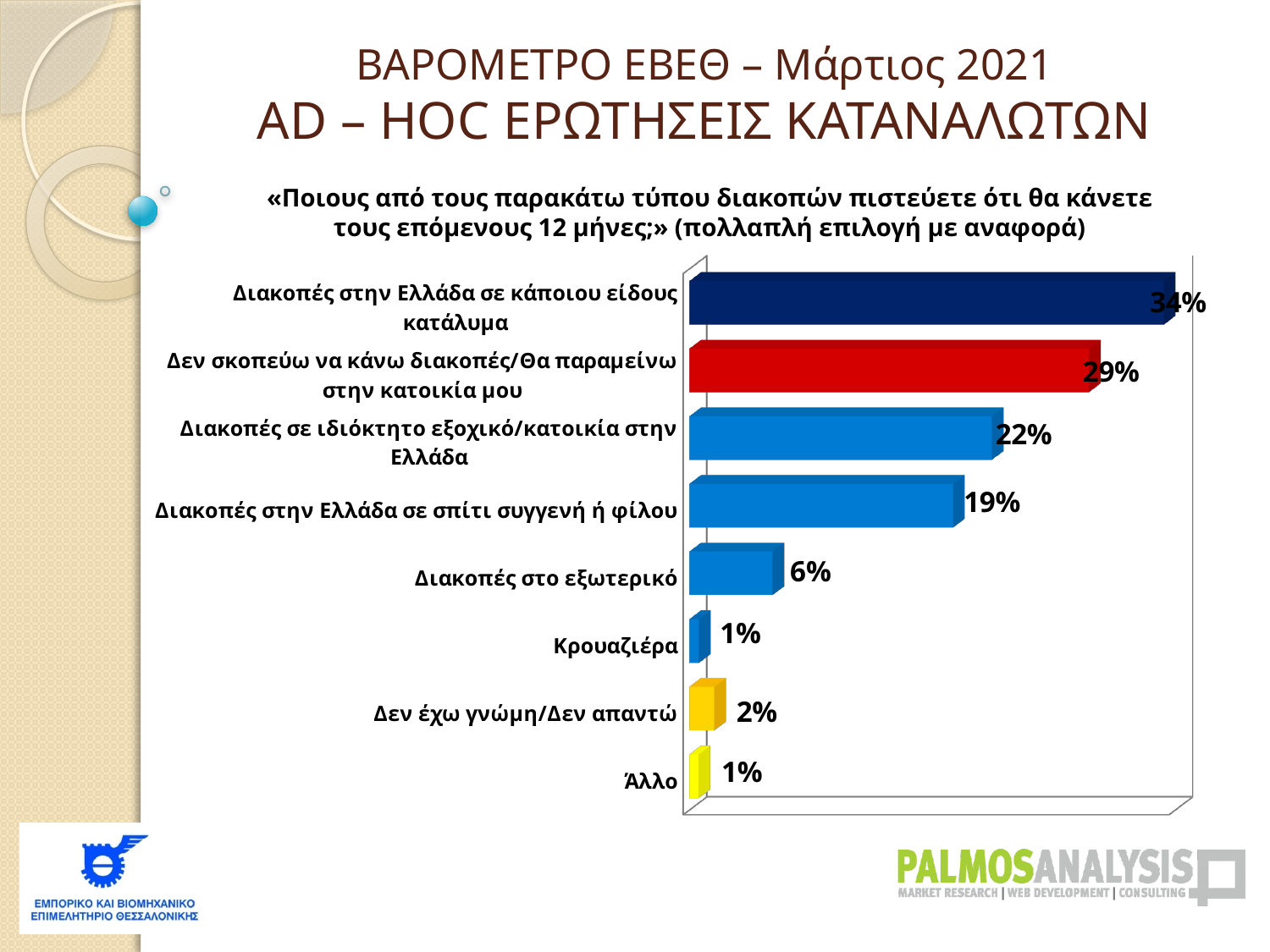
What is the value for «Δεν σκοπεύω να κάνω διακοπές/Θα παραμείνω στην κατοικία μου»? 29% What is the value for «Διακοπές στο εξωτερικό»? 6% What is the difference between «Διακοπές σε ιδιόκτητο εξοχικό/κατοικία στην Ελλάδα» and «Διακοπές στην Ελλάδα σε σπίτι συγγενή ή φίλου»? 3% What is the value for «Διακοπές στην Ελλάδα σε κάποιου είδους κατάλυμα»? 34% Which is larger: «Δεν σκοπεύω να κάνω διακοπές/Θα παραμείνω στην κατοικία μου» or «Διακοπές σε ιδιόκτητο εξοχικό/κατοικία στην Ελλάδα»? Δεν σκοπεύω να κάνω διακοπές/Θα παραμείνω στην κατοικία μου Which category has the highest value? Διακοπές στην Ελλάδα σε κάποιου είδους κατάλυμα What colour is the bar for «Δεν σκοπεύω να κάνω διακοπές/Θα παραμείνω στην κατοικία μου»? red What is the difference between the highest value and the value for «Διακοπές στο εξωτερικό»? 28% How many categories are shown in the chart? 8 What kind of chart is shown on the slide? bar chart What is the value for «Κρουαζιέρα»? 1% What is the value for «Δεν έχω γνώμη/Δεν απαντώ»? 2%